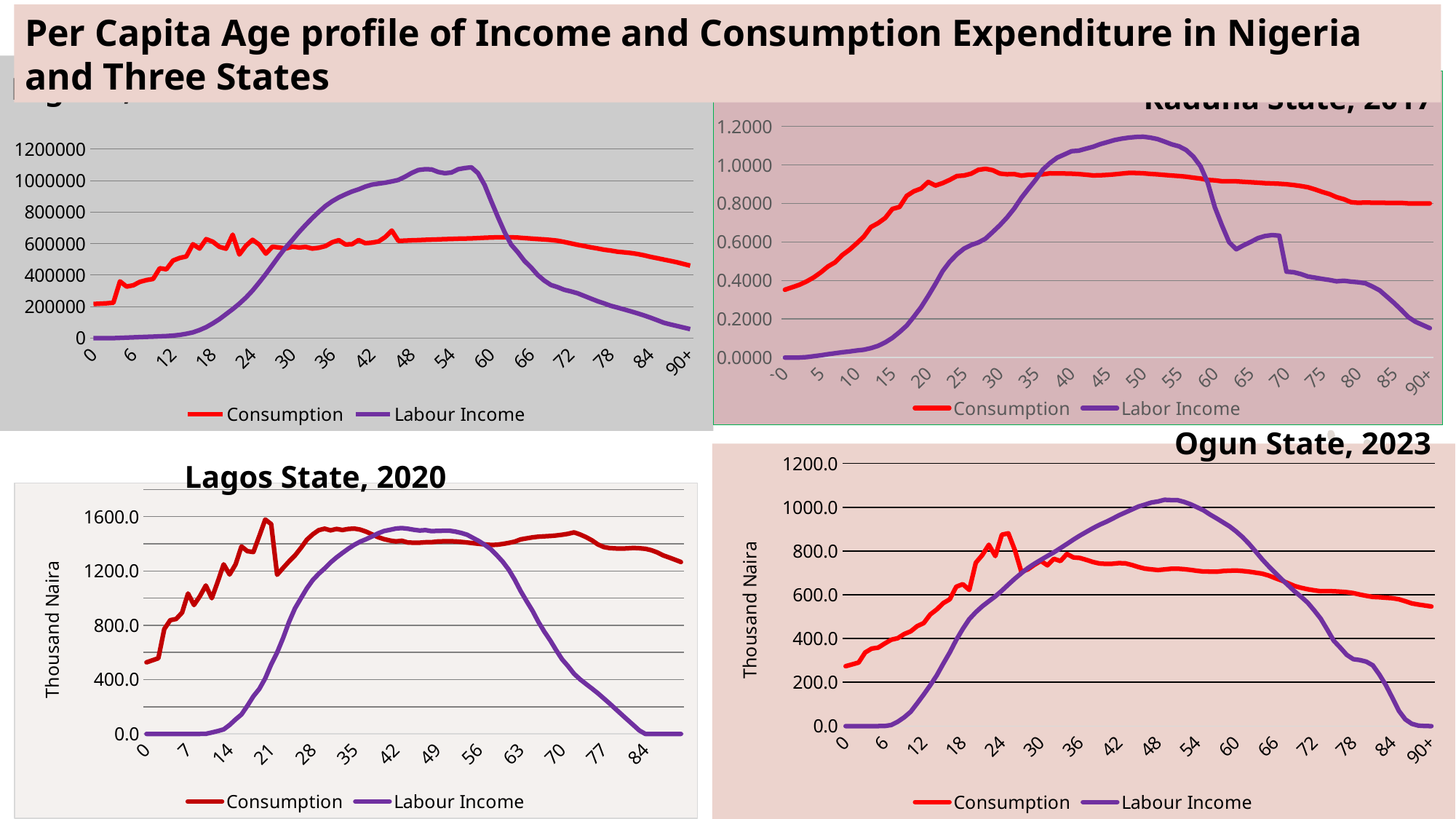
In the top-left chart, is the Labour Income value at age 54 greater or less than 800000? greater How many series does the legend of the Ogun State, 2023 chart list? 2 In the Kaduna State, 2017 chart, is the Consumption value at age 90+ greater or less than 0.6000? greater In the Kaduna State, 2017 chart, which series has the larger value at age 50, Consumption or Labor Income? Labor Income What are the two legend entries in the Lagos State, 2020 chart? Consumption and Labour Income In the Ogun State, 2023 chart, is the Labour Income value at age 48 greater or less than 800.0? greater In the Ogun State, 2023 chart, does the Labour Income line rise or fall from age 54 to age 90+? fall What kind of chart is the Lagos State, 2020 chart? line chart In the top-left chart, which series has the larger value at age 72, Consumption or Labour Income? Consumption What is the y-axis label of the Lagos State, 2020 chart? Thousand Naira In the Ogun State, 2023 chart, which series has the larger value at age 84, Consumption or Labour Income? Consumption